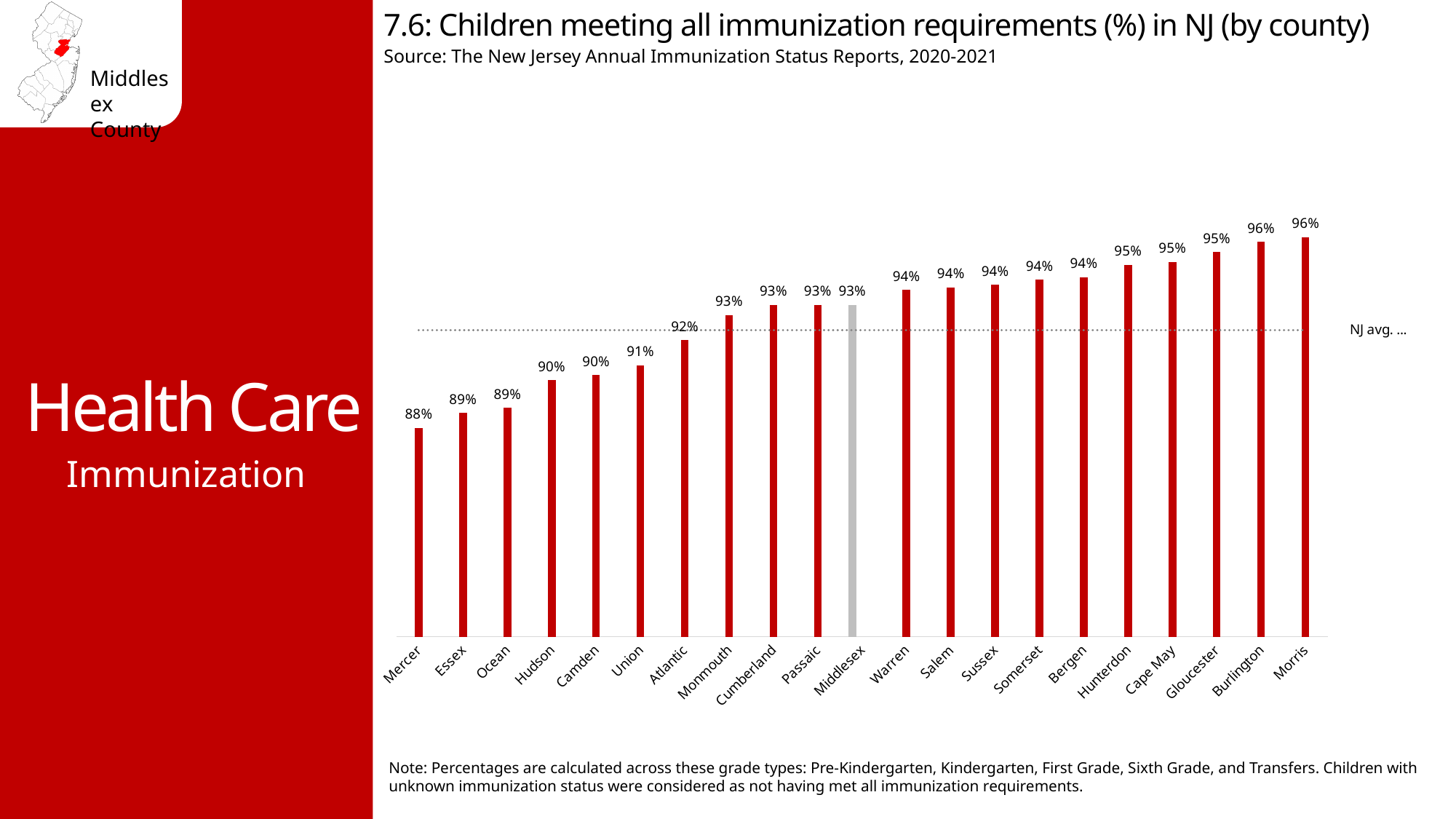
What percentage of children in Middlesex County met all immunization requirements? 93% Which has a higher value, Camden or Gloucester? Gloucester What type of chart is used on this slide? Bar chart What is the value shown for Atlantic County? 92% What is the difference in percentage points between Middlesex County and Mercer County? 5 percentage points Which has a higher value, Middlesex or Union? Middlesex How many counties are shown in the chart? 21 Which county's bar is shown in grey rather than red? Middlesex What is the difference in percentage points between Morris County and Mercer County? 8 percentage points What is the value shown for Mercer County? 88% What is the value shown for Hunterdon County? 95% Which county has the lowest percentage of children meeting all immunization requirements? Mercer